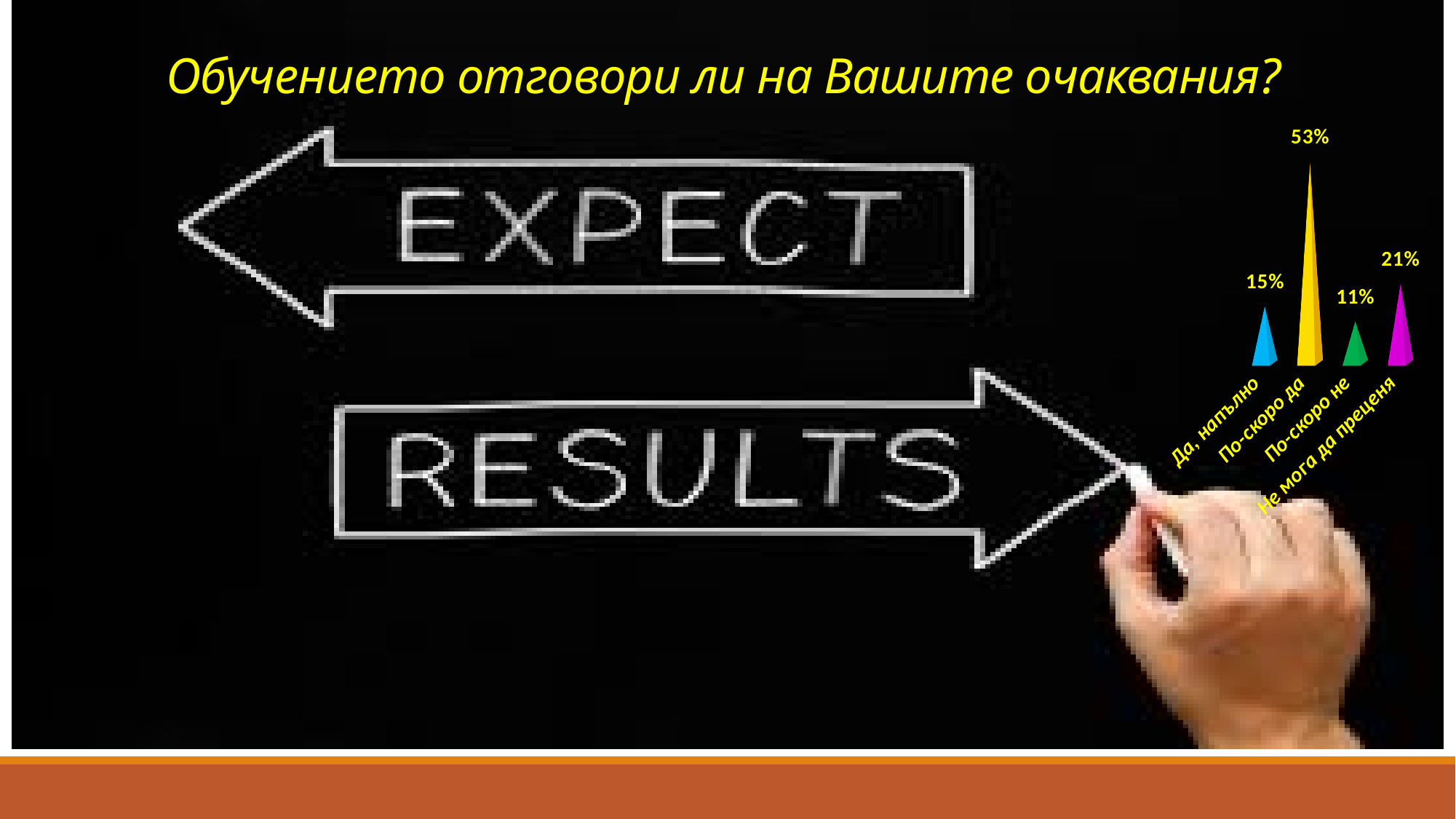
Which category has the highest value? По-скоро да Which category has the lowest value? По-скоро не What is the value for "По-скоро да"? 53% What colour is the bar for "По-скоро да"? Yellow What is the value for "По-скоро не"? 11% What is the value for "Да, напълно"? 15% What kind of chart is shown on the slide? Bar chart What is the difference between the values for "Да, напълно" and "По-скоро не"? 4% What is the difference between the values for "По-скоро да" and "Не мога да преценя"? 32% What is the value for "Не мога да преценя"? 21% Which is larger, the value for "Не мога да преценя" or the value for "Да, напълно"? Не мога да преценя How many categories does the chart show? 4